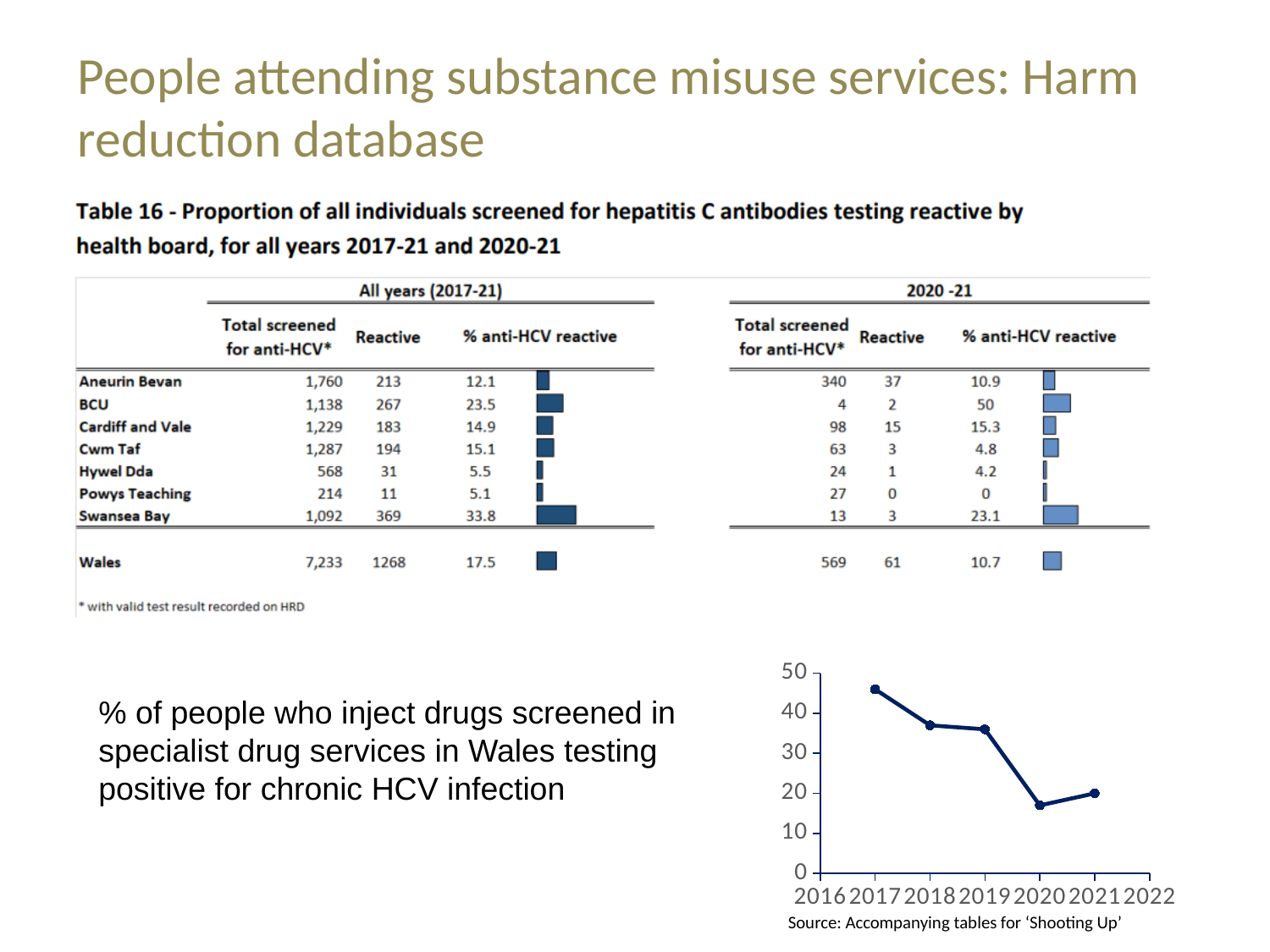
In the line chart at the bottom right, which is larger, the value for 2017 or the value for 2020? 2017 In Table 16, which health board has the highest % anti-HCV reactive for all years (2017-21)? Swansea Bay In the line chart at the bottom right, which year has the lowest value? 2020 What source is cited beneath the line chart at the bottom right? Accompanying tables for 'Shooting Up' In the line chart at the bottom right, do the values generally rise or fall from 2017 to 2021? fall In the line chart at the bottom right, is the value for 2019 greater or less than 30? greater In the line chart at the bottom right, is the value for 2020 greater or less than 20? less What kind of chart is shown at the bottom right of the slide? line chart In the line chart at the bottom right, how many data points are plotted? 5 In Table 16, what is the % anti-HCV reactive for Wales for all years (2017-21)? 17.5 In the line chart at the bottom right, is the value for 2017 greater or less than 40? greater In the line chart at the bottom right, which year has the highest value? 2017